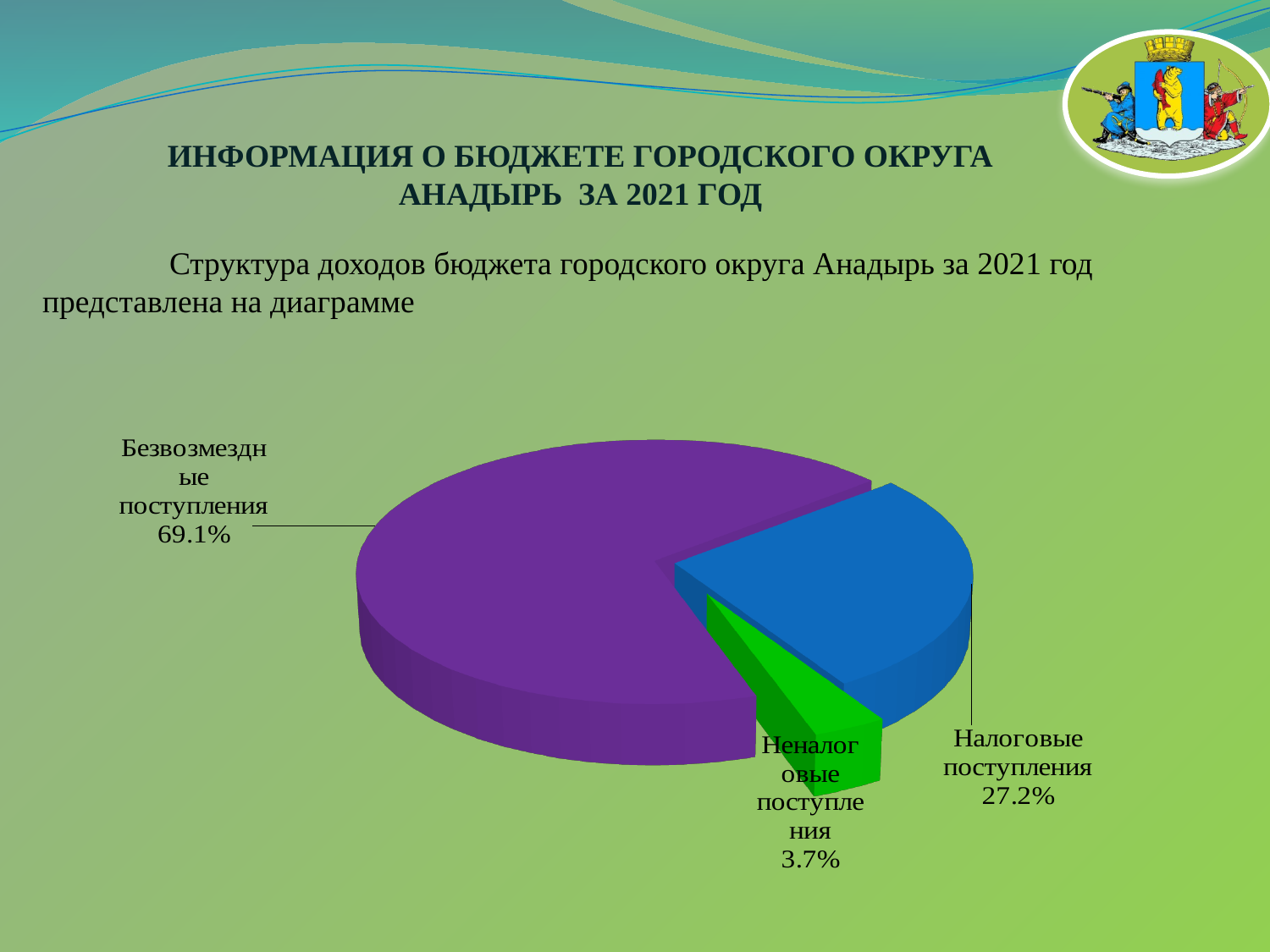
What colour is the slice for Неналоговые поступления? green Which category has the largest slice of the pie? Безвозмездные поступления Which category has the smallest slice of the pie? Неналоговые поступления What is the difference in percentage points between Безвозмездные поступления and Налоговые поступления? 41.9 What is the difference in percentage points between Налоговые поступления and Неналоговые поступления? 23.5 What kind of chart is shown on the slide? pie chart What share of the pie does Налоговые поступления have? 27.2% How many slices does the pie chart have? 3 What colour is the slice for Безвозмездные поступления? purple Which is larger, Налоговые поступления or Неналоговые поступления? Налоговые поступления What share of the pie does Безвозмездные поступления have? 69.1% What share of the pie does Неналоговые поступления have? 3.7%